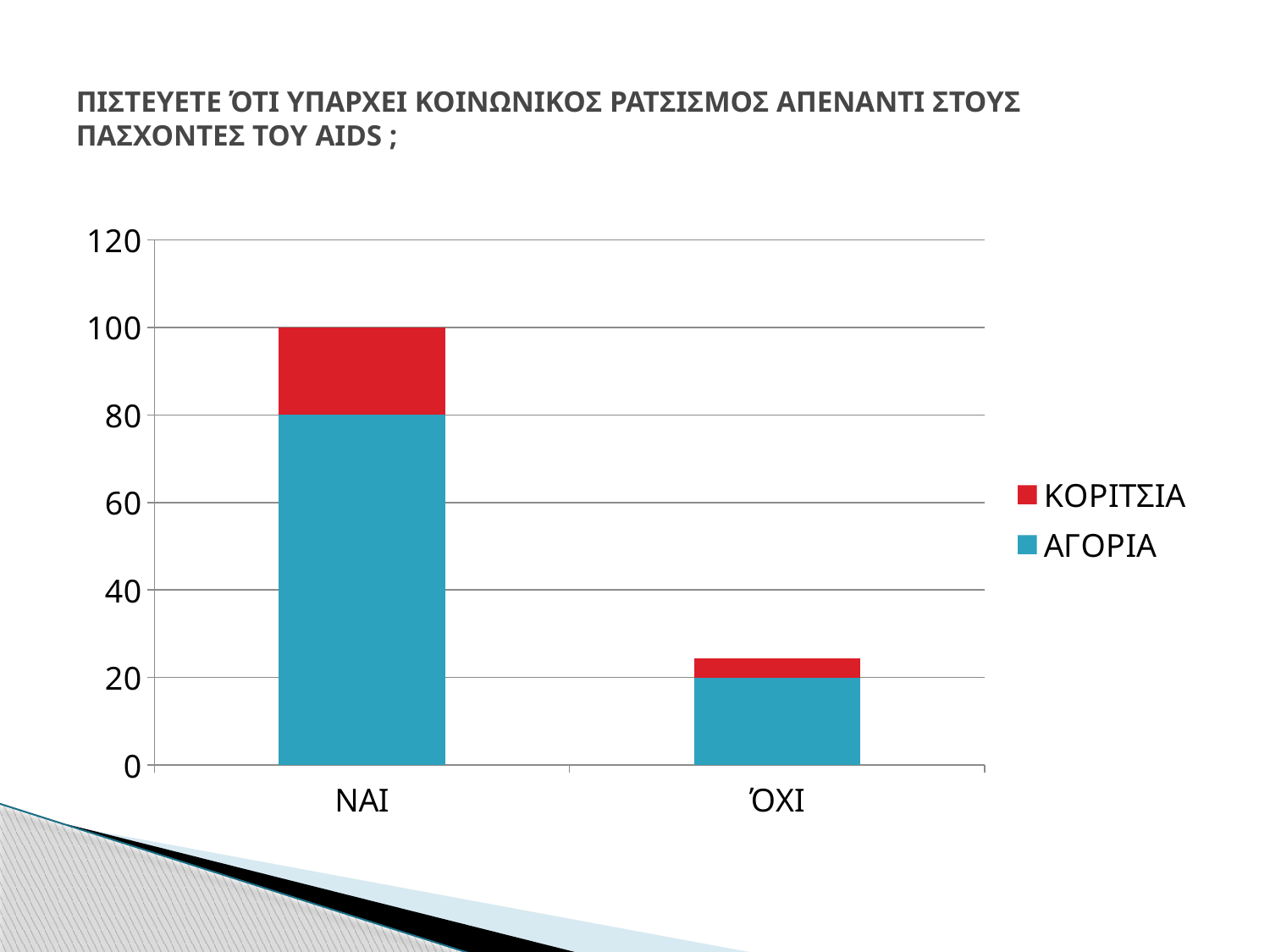
Which category has the taller stacked bar? ΝΑΙ Which category has the larger ΑΓΟΡΙΑ value, ΝΑΙ or ΌΧΙ? ΝΑΙ Is the total of the stacked bar for ΌΧΙ greater or less than 40? less Is the ΚΟΡΙΤΣΙΑ value for ΌΧΙ greater or less than 20? less How many series does the legend list? 2 What is the difference between the ΑΓΟΡΙΑ value for ΝΑΙ and the ΑΓΟΡΙΑ value for ΌΧΙ? 60 What is the value of ΑΓΟΡΙΑ for ΌΧΙ? 20 How many categories are shown on the x axis? 2 What is the value of ΑΓΟΡΙΑ for ΝΑΙ? 80 What kind of chart is shown on the slide? bar chart What is the total height of the stacked bar for ΝΑΙ? 100 What colour represents the ΚΟΡΙΤΣΙΑ series? red